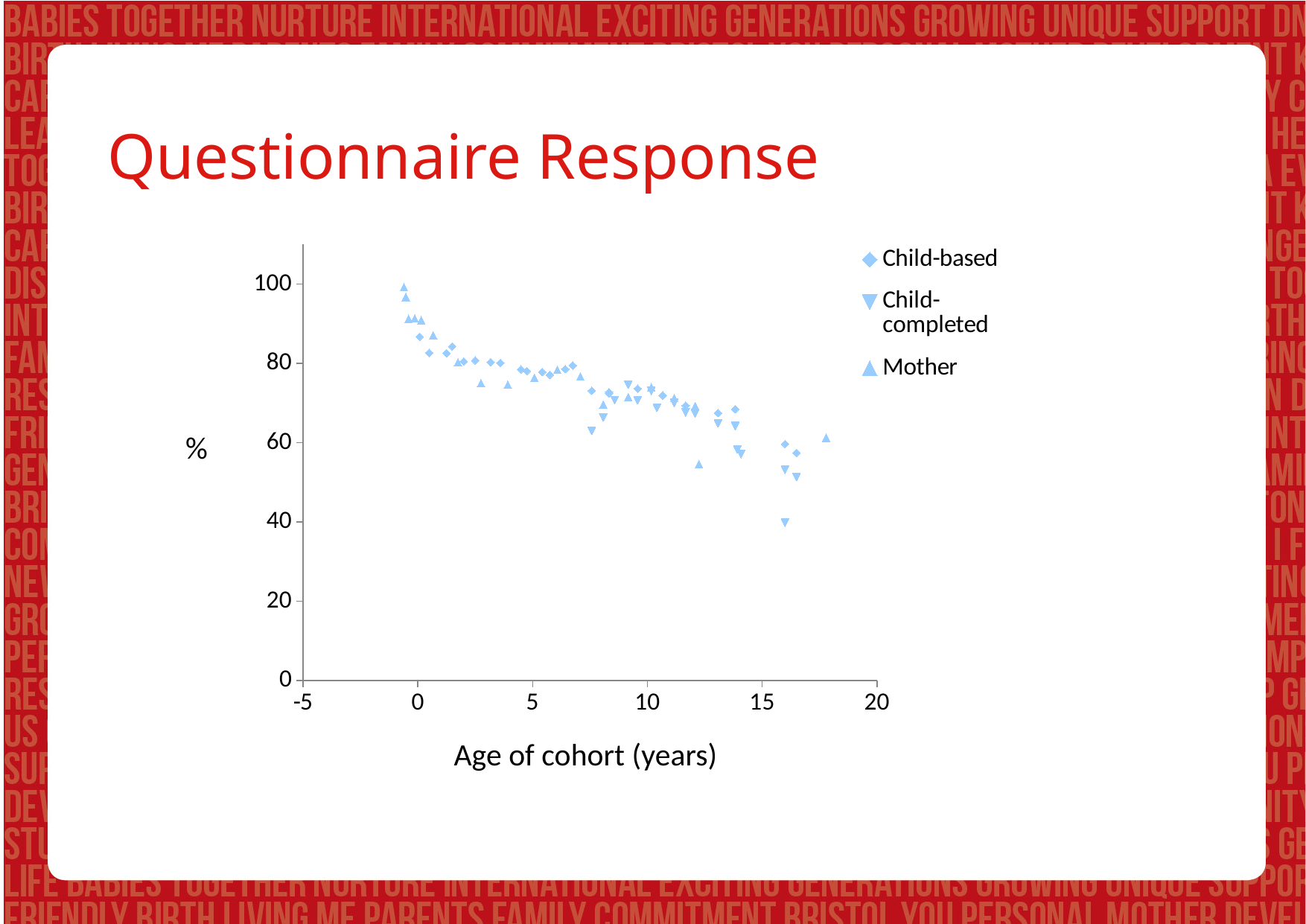
What kind of chart is shown on the slide? scatter chart Is the lowest Child-completed value, at around age 16, greater or less than 60? less Is the Mother value at around age 12 greater or less than 60? less How many series does the legend list? 3 Is the Child-based value at around age 5 greater or less than 60? greater What is the label of the x axis? Age of cohort (years) Which series has the lowest plotted value on the chart? Child-completed Do the response percentages generally rise or fall as the age of the cohort increases? fall What are the three series named in the legend? Child-based, Child-completed, Mother